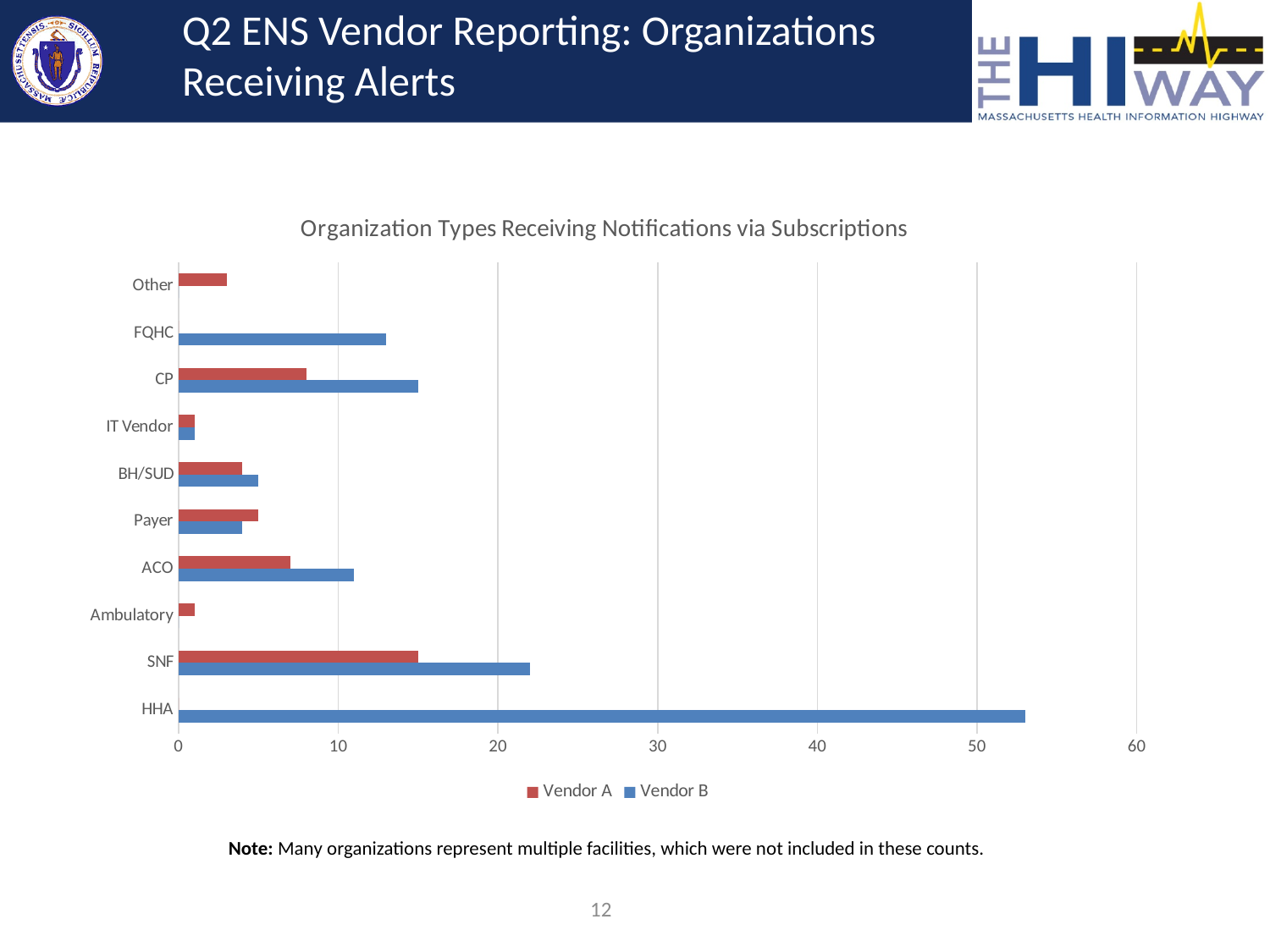
Is the Vendor B value for HHA greater or less than 50? greater How many organization types are shown on the chart? 10 For SNF, which is larger: the Vendor A value or the Vendor B value? Vendor B Which organization type has the highest Vendor A value? SNF Is the Vendor B value for FQHC greater or less than 10? greater For CP, which is larger: the Vendor A value or the Vendor B value? Vendor B Is the Vendor B value for SNF greater or less than 20? greater Which organization type has the highest Vendor B value? HHA How many series does the legend list? 2 What type of chart is shown on the slide? Bar chart What is the title of the chart? Organization Types Receiving Notifications via Subscriptions